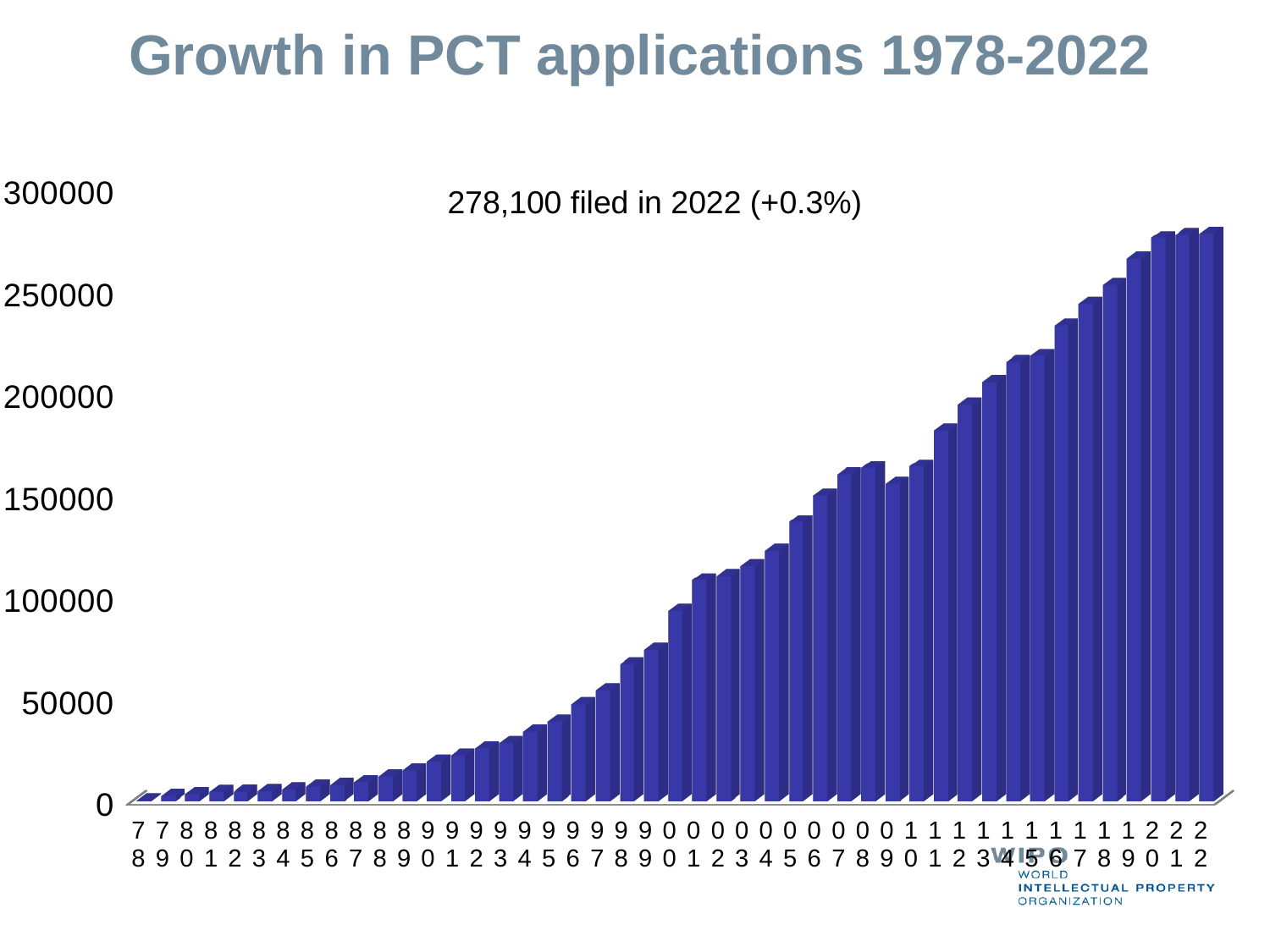
Do the values generally rise or fall from 1978 to 2022? rise What percentage change in PCT applications is noted for 2022? +0.3% Is the value for 2000 greater or less than 100000? less What is the title of the chart? Growth in PCT applications 1978-2022 Which year has the larger value, 2000 or 2010? 2010 Which year has the larger value, 2008 or 2009? 2008 Is the value for 2019 greater or less than 250000? greater Which year has the lowest number of PCT applications? 1978 How many years (bars) are plotted on the chart? 45 What kind of chart is shown on the slide? bar chart How many PCT applications were filed in 2022 according to the slide? 278,100 Is the value for 2010 greater or less than 150000? greater